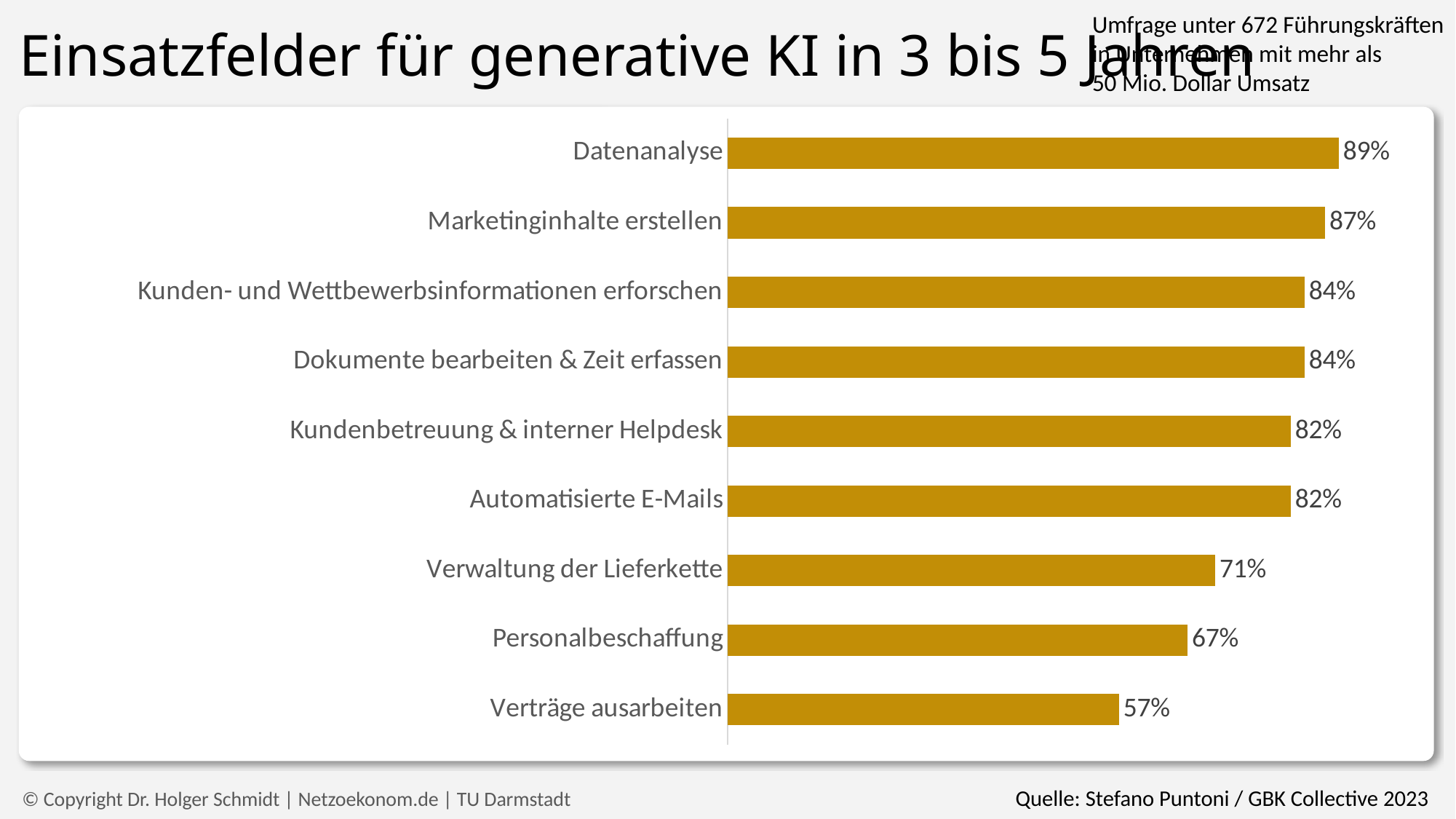
What is the value for Verwaltung der Lieferkette? 71% Which is larger, the value for Automatisierte E-Mails or the value for Verwaltung der Lieferkette? Automatisierte E-Mails What is the value for Personalbeschaffung? 67% What is the difference between the values for Datenanalyse and Verträge ausarbeiten? 32% What is the difference between the values for Marketinginhalte erstellen and Personalbeschaffung? 20% What is the value for Datenanalyse? 89% What colour are the bars in the chart? Gold Which category has the lowest value? Verträge ausarbeiten How many categories are shown in the chart? 9 Which category has the highest value? Datenanalyse What is the title of the slide? Einsatzfelder für generative KI in 3 bis 5 Jahren What kind of chart is shown on the slide? Bar chart